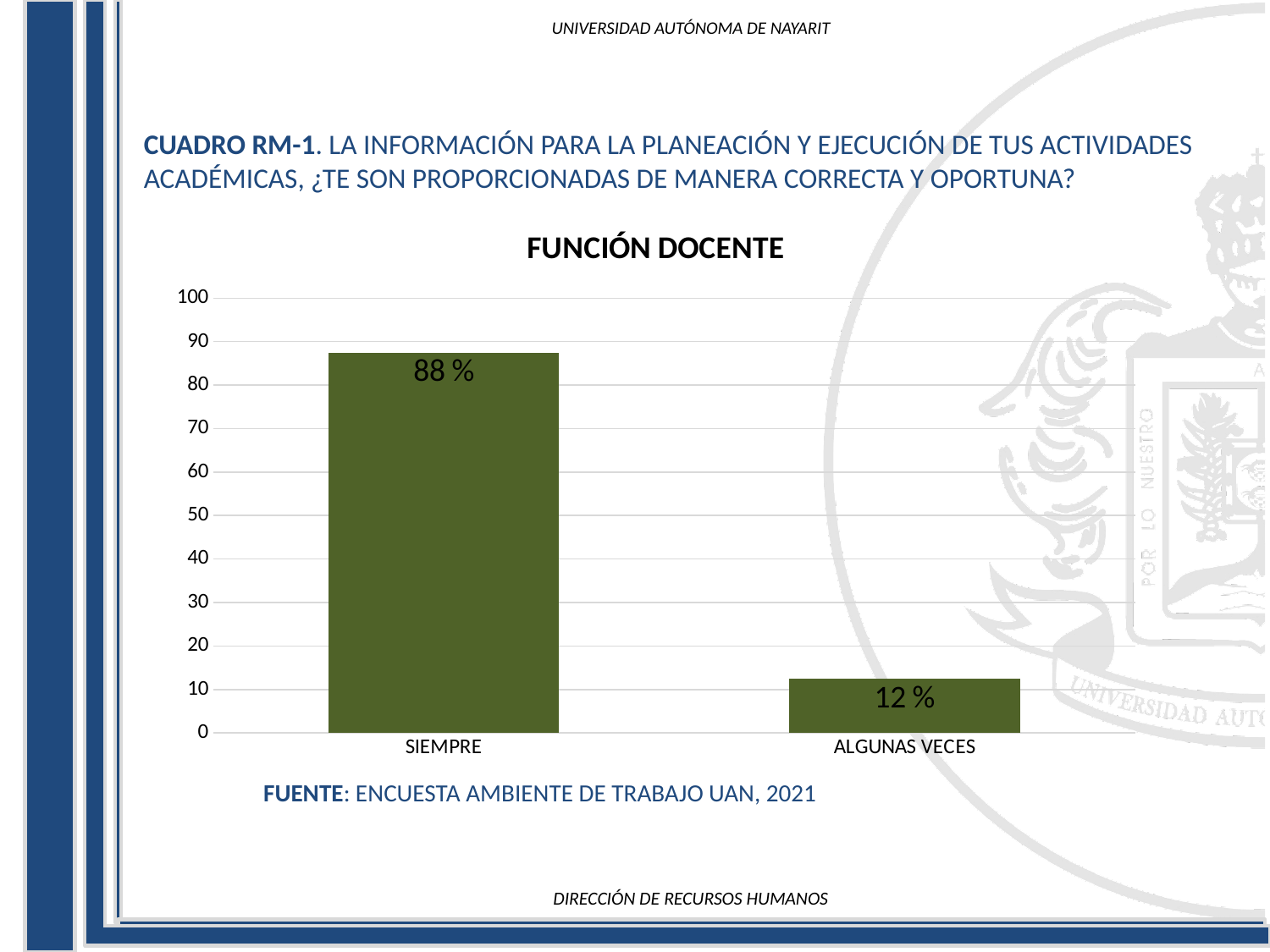
What is the highest value shown on the vertical axis? 100 What is the value for ALGUNAS VECES? 12 % What is the title of the chart? FUNCIÓN DOCENTE What is the difference between the values for SIEMPRE and ALGUNAS VECES? 76 % What kind of chart is shown on the slide? bar chart Which category has the highest value? SIEMPRE How many categories are shown in the chart? 2 Which is larger, the value for SIEMPRE or the value for ALGUNAS VECES? SIEMPRE Is the value for SIEMPRE greater or less than 50? greater Which category has the lowest value? ALGUNAS VECES What is the value for SIEMPRE? 88 % Is the value for ALGUNAS VECES greater or less than 20? less